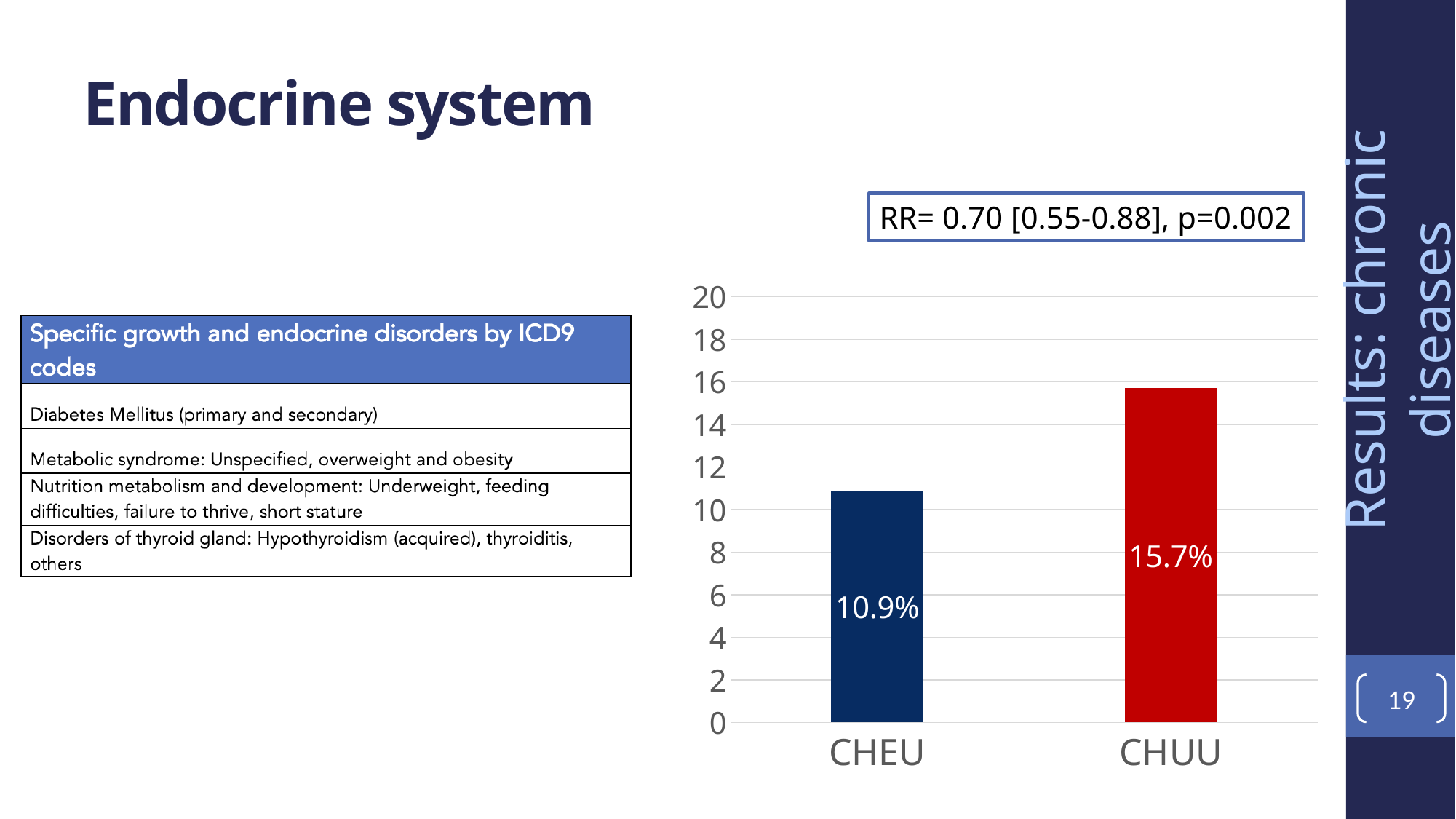
What kind of chart is shown on the slide? bar chart How many categories are shown on the x axis? 2 Which is larger, the value for CHEU or the value for CHUU? CHUU Which category has the lowest value? CHEU What is the maximum value shown on the y axis? 20 What is the value for CHUU? 15.7% What colour is the bar for CHUU? red What is the difference between the values for CHUU and CHEU? 4.8% Is the value for CHEU greater or less than 12? less Which category has the highest value? CHUU Is the value for CHUU greater or less than 14? greater What is the value for CHEU? 10.9%